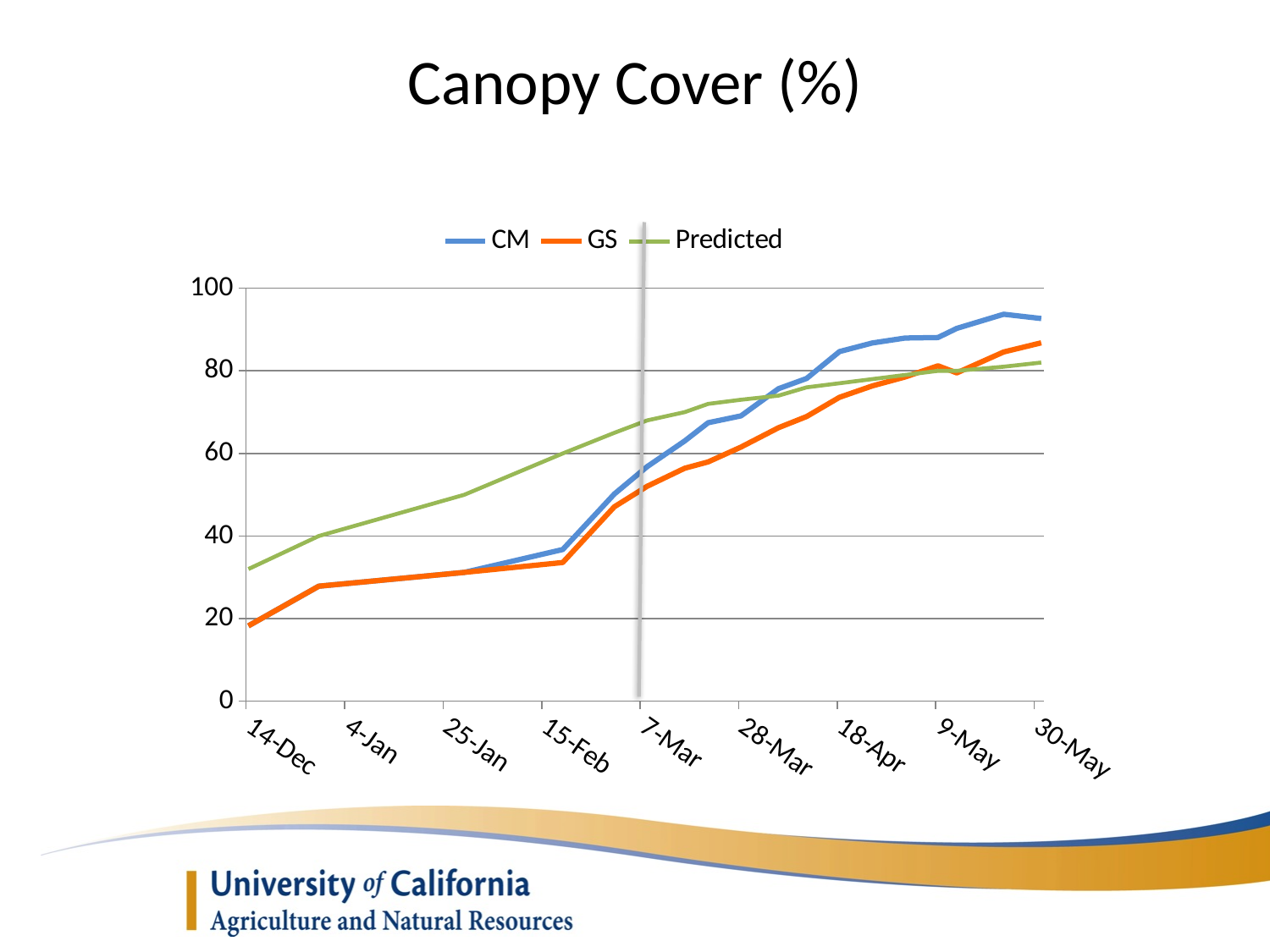
Is the CM value at 30-May greater or less than 80? greater How many date labels are shown on the x axis? 9 Do the CM values rise or fall from 14-Dec to 30-May? Rise Is the Predicted value at 14-Dec greater or less than 20? greater Is the GS value at 14-Dec greater or less than 20? less Which series has the highest value at 30-May? CM What is the title of the chart? Canopy Cover (%) How many series does the legend list? 3 What kind of chart is shown on the slide? Line chart At 14-Dec, which is larger: the Predicted value or the GS value? Predicted What are the names of the series in the legend? CM, GS, Predicted